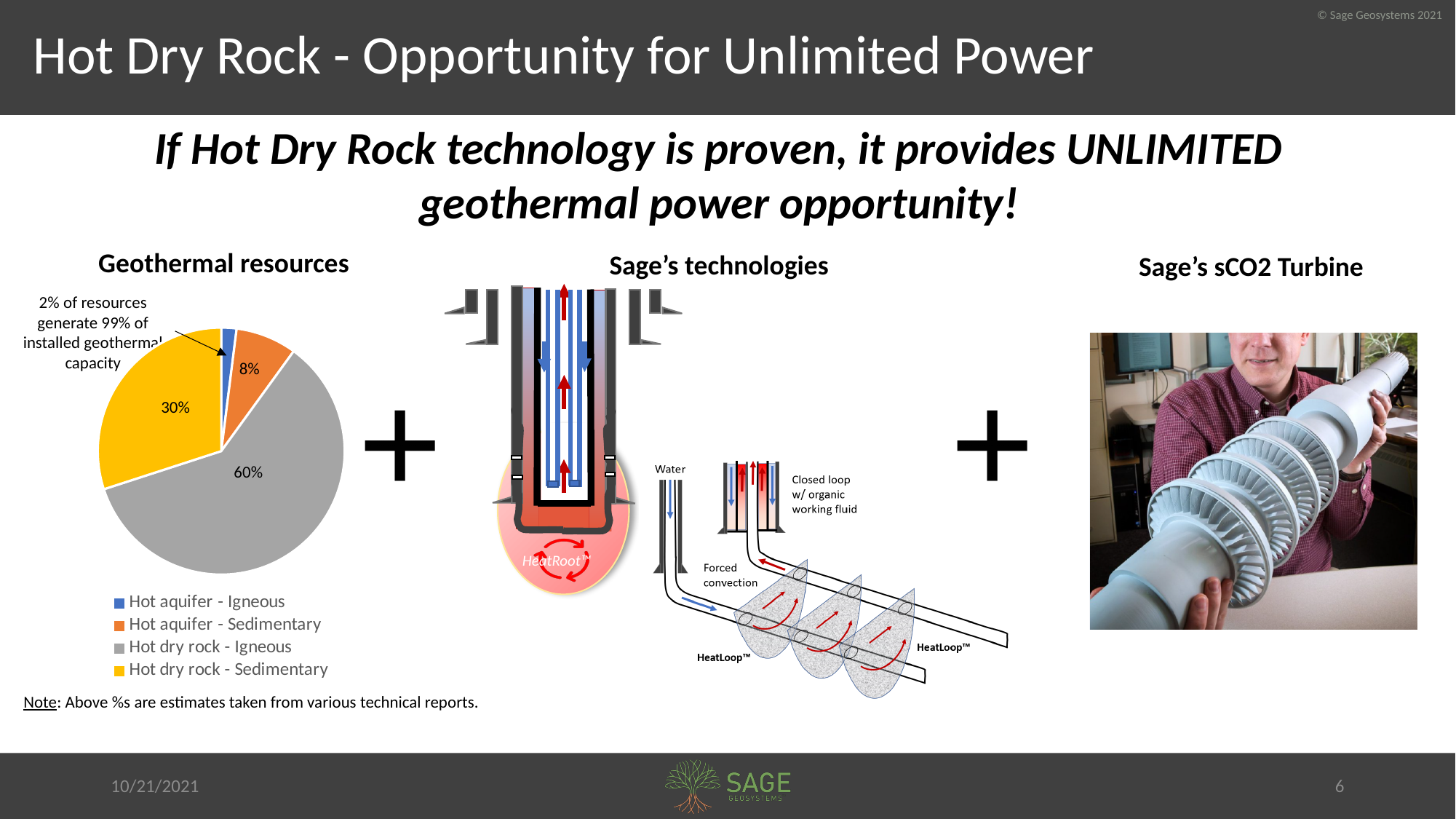
In the Geothermal resources pie chart, what is the combined share of the two Hot dry rock categories? 90% In the Geothermal resources pie chart, what percentage of resources does the annotation give for the Hot aquifer - Igneous slice? 2% In the Geothermal resources pie chart, which is larger: Hot aquifer - Sedimentary or Hot dry rock - Sedimentary? Hot dry rock - Sedimentary What colour represents Hot dry rock - Sedimentary in the Geothermal resources pie chart? Yellow In the Geothermal resources pie chart, what share is labelled for Hot aquifer - Sedimentary? 8% What kind of chart is shown under the heading "Geothermal resources"? Pie chart Which category has the smallest slice in the Geothermal resources pie chart? Hot aquifer - Igneous In the Geothermal resources pie chart, how many percentage points larger is Hot dry rock - Igneous than Hot dry rock - Sedimentary? 30 percentage points In the Geothermal resources pie chart, what share is labelled for Hot dry rock - Igneous? 60% Which category has the largest slice in the Geothermal resources pie chart? Hot dry rock - Igneous How many categories does the legend of the Geothermal resources pie chart list? 4 In the Geothermal resources pie chart, what share is labelled for Hot dry rock - Sedimentary? 30%